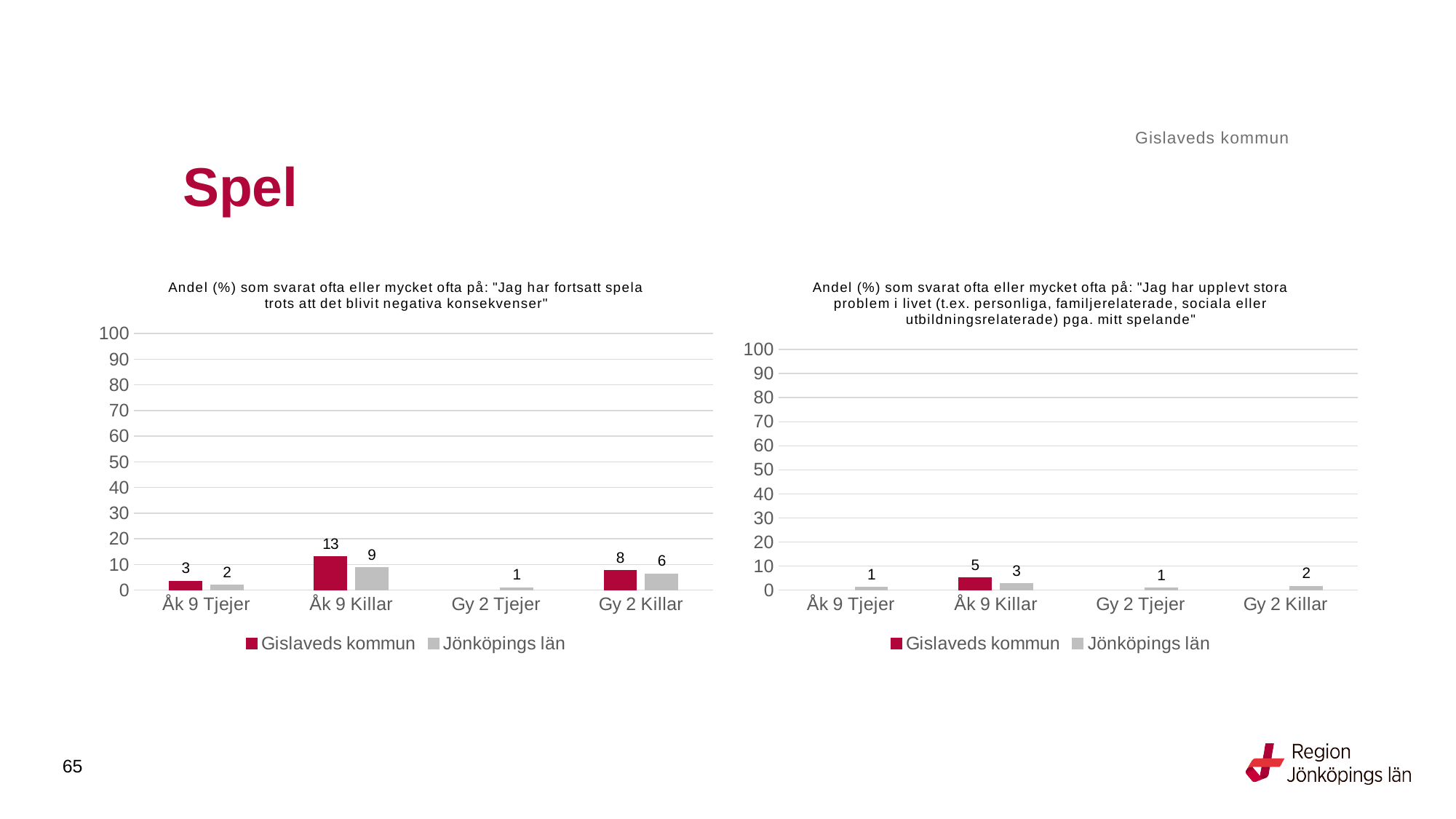
In the left chart, which category has the highest value for Gislaveds kommun? Åk 9 Killar What type of chart is the left chart? Bar chart How many categories are shown on the x axis of the left chart? 4 In the right chart, what is the value for Jönköpings län for Gy 2 Killar? 2 In the left chart, what is the value for Gislaveds kommun for Åk 9 Killar? 13 In the left chart, what is the value for Jönköpings län for Gy 2 Killar? 6 In the left chart, which is larger for Gy 2 Killar: Gislaveds kommun or Jönköpings län? Gislaveds kommun In the right chart, what is the value for Gislaveds kommun for Åk 9 Killar? 5 In the right chart, what is the difference between Gislaveds kommun and Jönköpings län for Åk 9 Killar? 2 In the right chart, which category has the highest value for Jönköpings län? Åk 9 Killar In the left chart, what is the difference between Gislaveds kommun and Jönköpings län for Åk 9 Killar? 4 How many series does the legend of the right chart list? 2